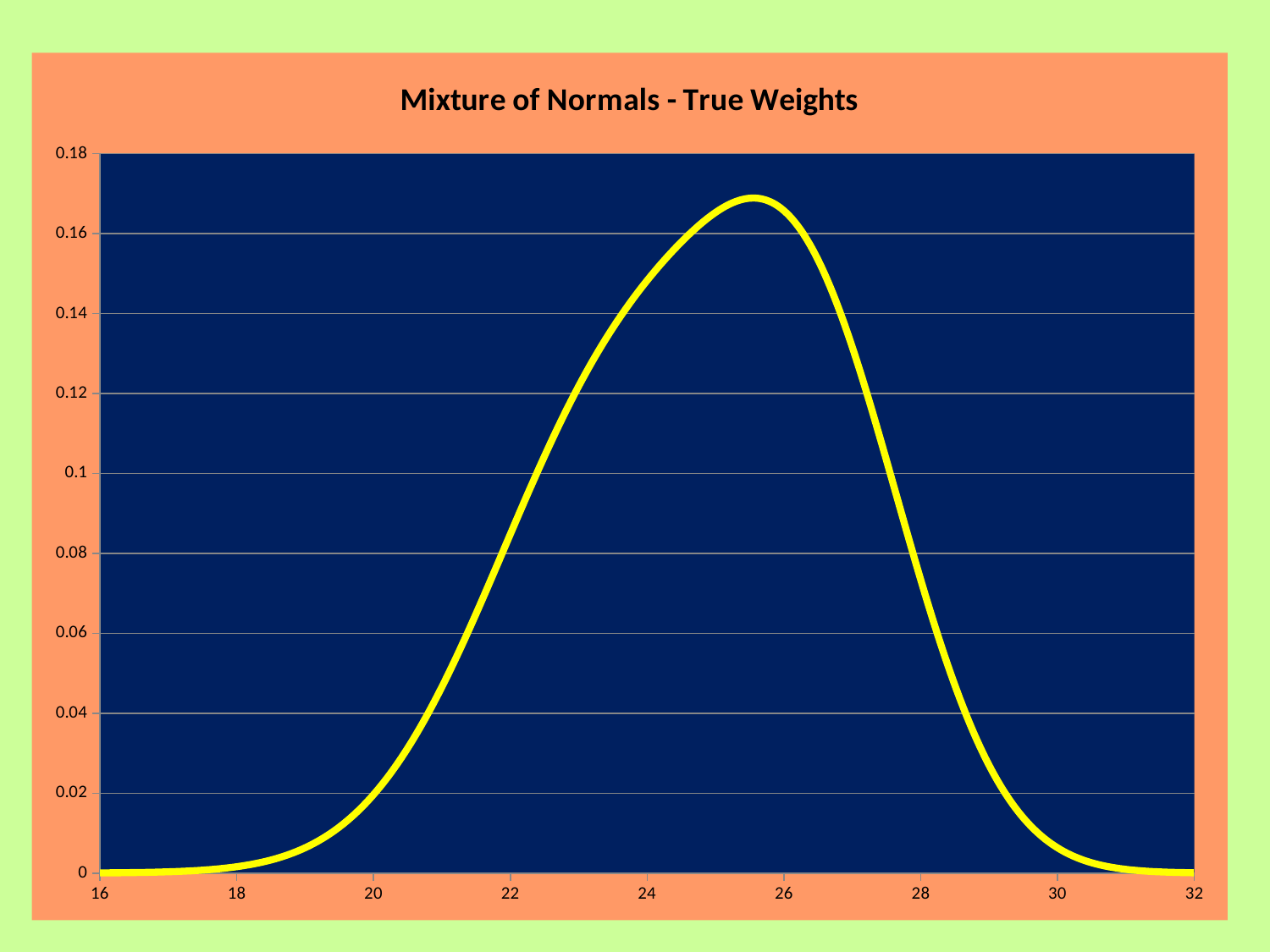
Which has the larger value on the curve, x = 22 or x = 26? x = 26 What is the highest value shown on the vertical axis? 0.18 Is the value of the curve at x = 26 greater or less than 0.14? greater Is the value of the curve at x = 24 greater or less than 0.14? greater Which has the larger value on the curve, x = 24 or x = 28? x = 24 Is the value of the curve at x = 22 greater or less than 0.1? less Does the curve rise or fall as x goes from 26 to 32? fall Does the curve rise or fall as x goes from 16 to 24? rise What kind of chart is shown on the slide? line chart What is the title of the chart? Mixture of Normals - True Weights